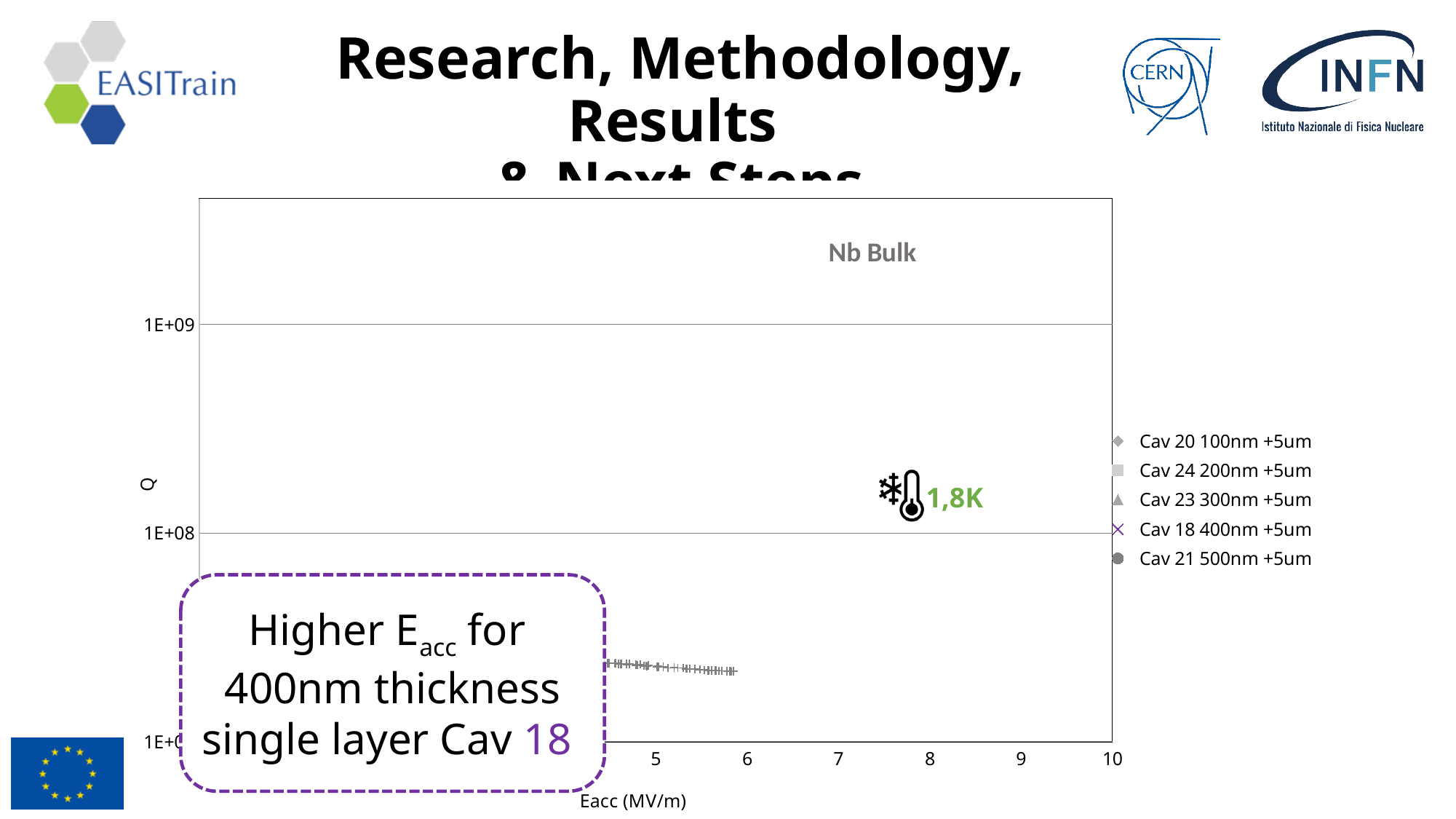
What is the label of the x axis of the chart? Eacc (MV/m) What kind of chart is shown on the slide? scatter chart Which legend entry corresponds to the 400nm thickness cavity? Cav 18 400nm +5um Does the Q value of the plotted Cav 18 400nm +5um series rise or fall as Eacc increases? fall How many series does the chart legend list? 5